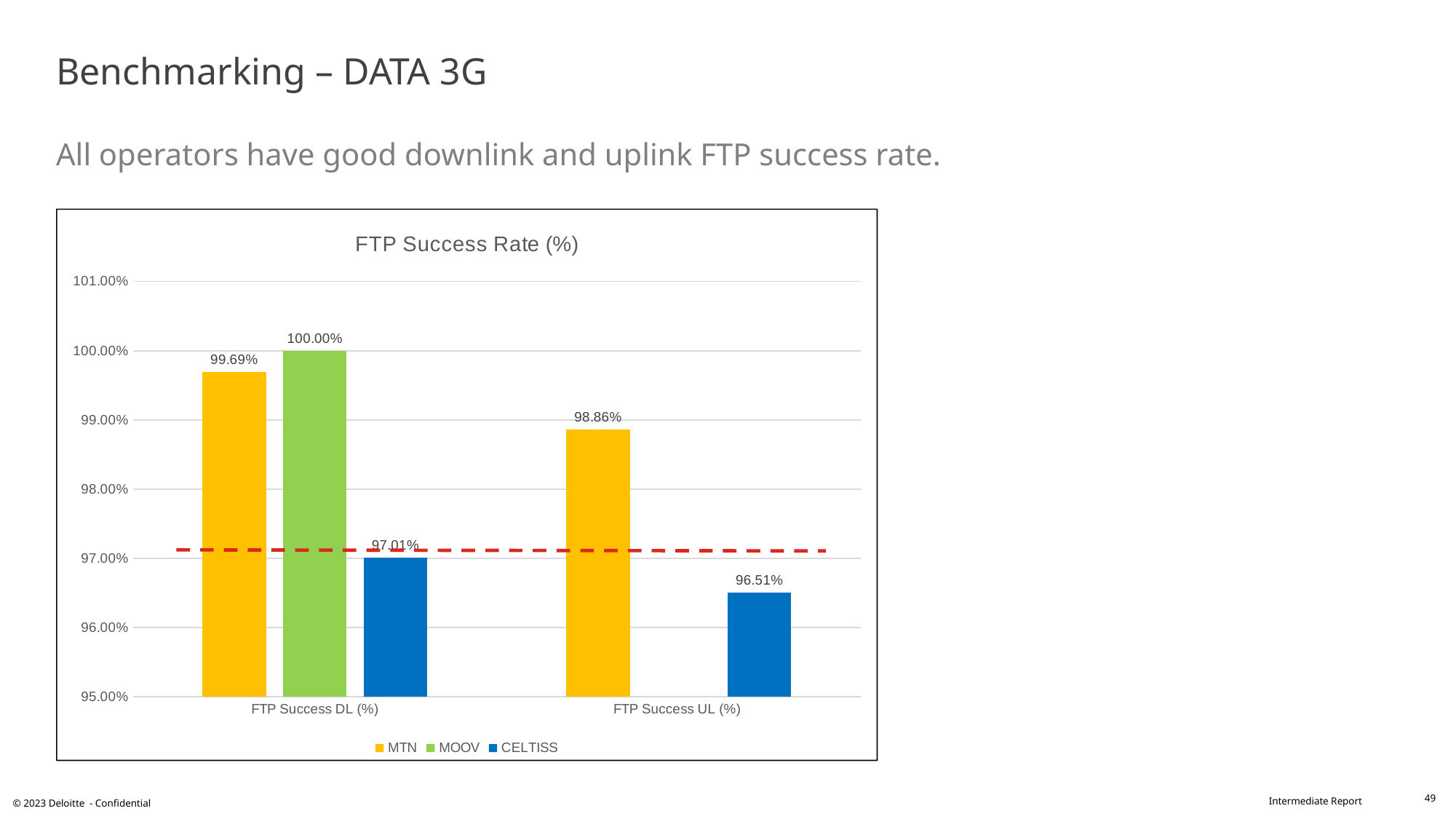
Which operator has the highest FTP Success DL (%)? MOOV What is the title of the chart? FTP Success Rate (%) What is the FTP Success UL (%) value for CELTISS? 96.51% What is the FTP Success DL (%) value for MTN? 99.69% Is the FTP Success UL (%) value for CELTISS greater or less than 97.00%? less What is the FTP Success DL (%) value for MOOV? 100.00% How many series does the legend list? 3 What is the difference between MTN's FTP Success DL (%) and FTP Success UL (%)? 0.83% Which is larger: CELTISS's FTP Success DL (%) or CELTISS's FTP Success UL (%)? FTP Success DL (%) What is the FTP Success UL (%) value for MTN? 98.86% What type of chart is shown on the slide? Bar chart